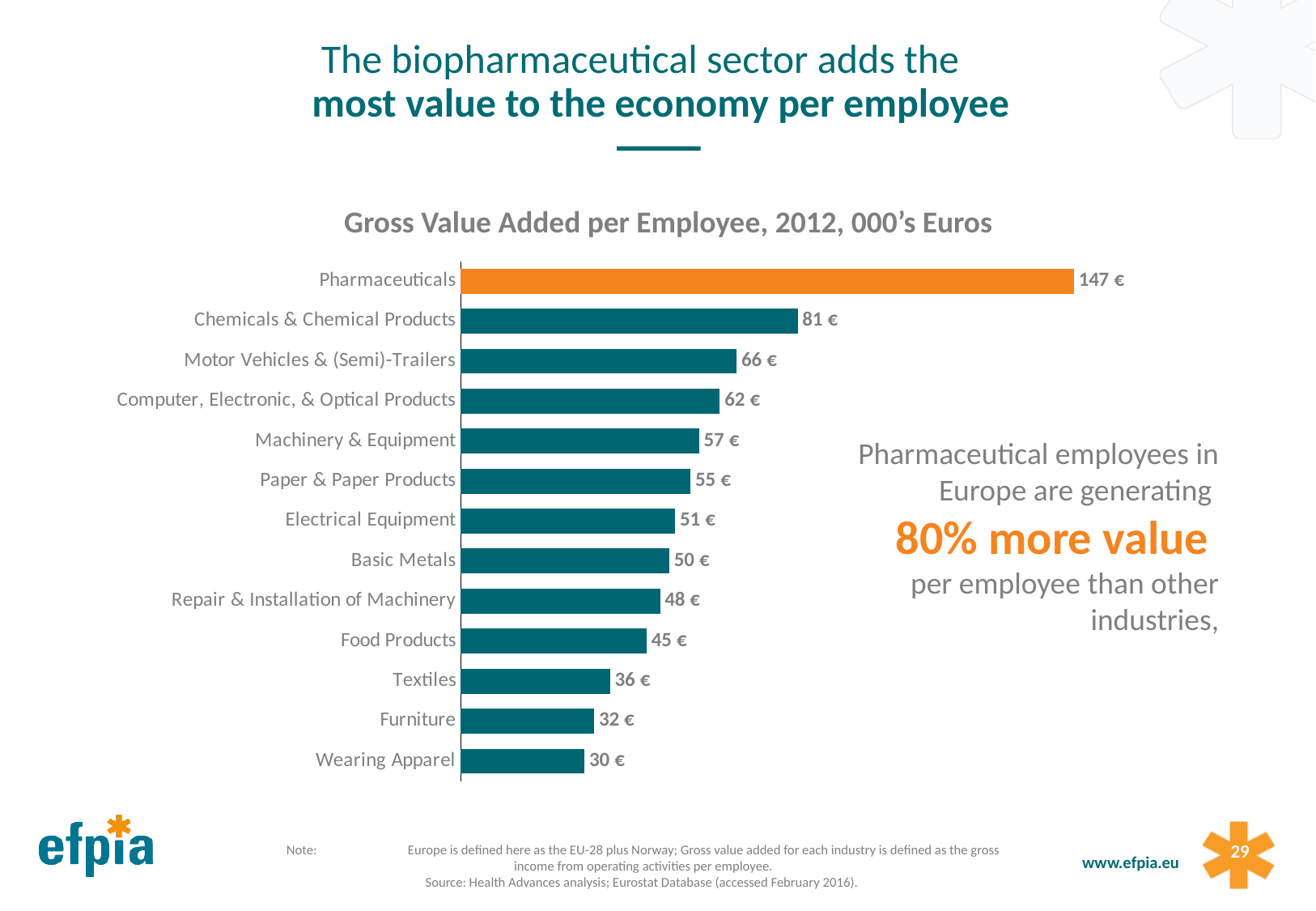
Which industry has the highest gross value added per employee? Pharmaceuticals Which has a higher value: Machinery & Equipment or Paper & Paper Products? Machinery & Equipment What type of chart is shown on the slide? Bar chart What is the difference between the values for Pharmaceuticals and Chemicals & Chemical Products? 66 € What is the title of the chart? Gross Value Added per Employee, 2012, 000's Euros What is the difference between the values for Motor Vehicles & (Semi)-Trailers and Food Products? 21 € How many industries are shown in the chart? 13 Which industry has the lowest gross value added per employee? Wearing Apparel Which has a higher value: Furniture or Textiles? Textiles What is the value shown for Chemicals & Chemical Products? 81 € What is the gross value added per employee for Pharmaceuticals? 147 € What is the value shown for Textiles? 36 €